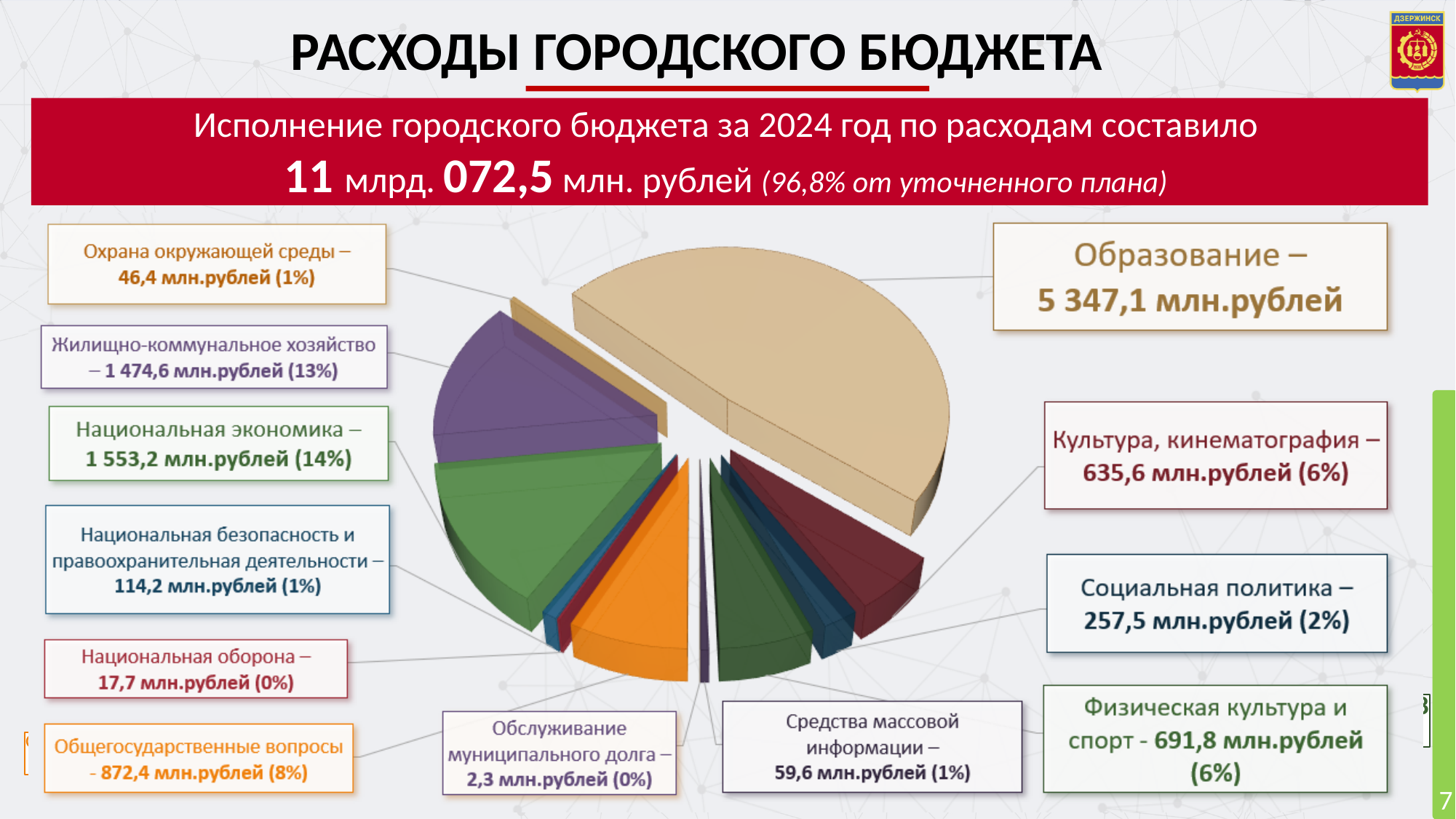
What is the title of the slide containing the pie chart? РАСХОДЫ ГОРОДСКОГО БЮДЖЕТА What is the value for Национальная экономика? 1 553,2 млн.рублей What is the value for Образование? 5 347,1 млн.рублей What is the value for Социальная политика? 257,5 млн.рублей Which expenditure category has the smallest value on the pie chart? Обслуживание муниципального долга What share of the pie does Общегосударственные вопросы represent? 8% What type of chart is shown on the slide? Pie chart Which expenditure category has the largest slice of the pie chart? Образование What share of the pie does Жилищно-коммунальное хозяйство represent? 13% What is the difference between Национальная экономика and Жилищно-коммунальное хозяйство? 78,6 млн.рублей Which is larger: Физическая культура и спорт or Культура, кинематография? Физическая культура и спорт How many expenditure categories are labelled on the pie chart? 12